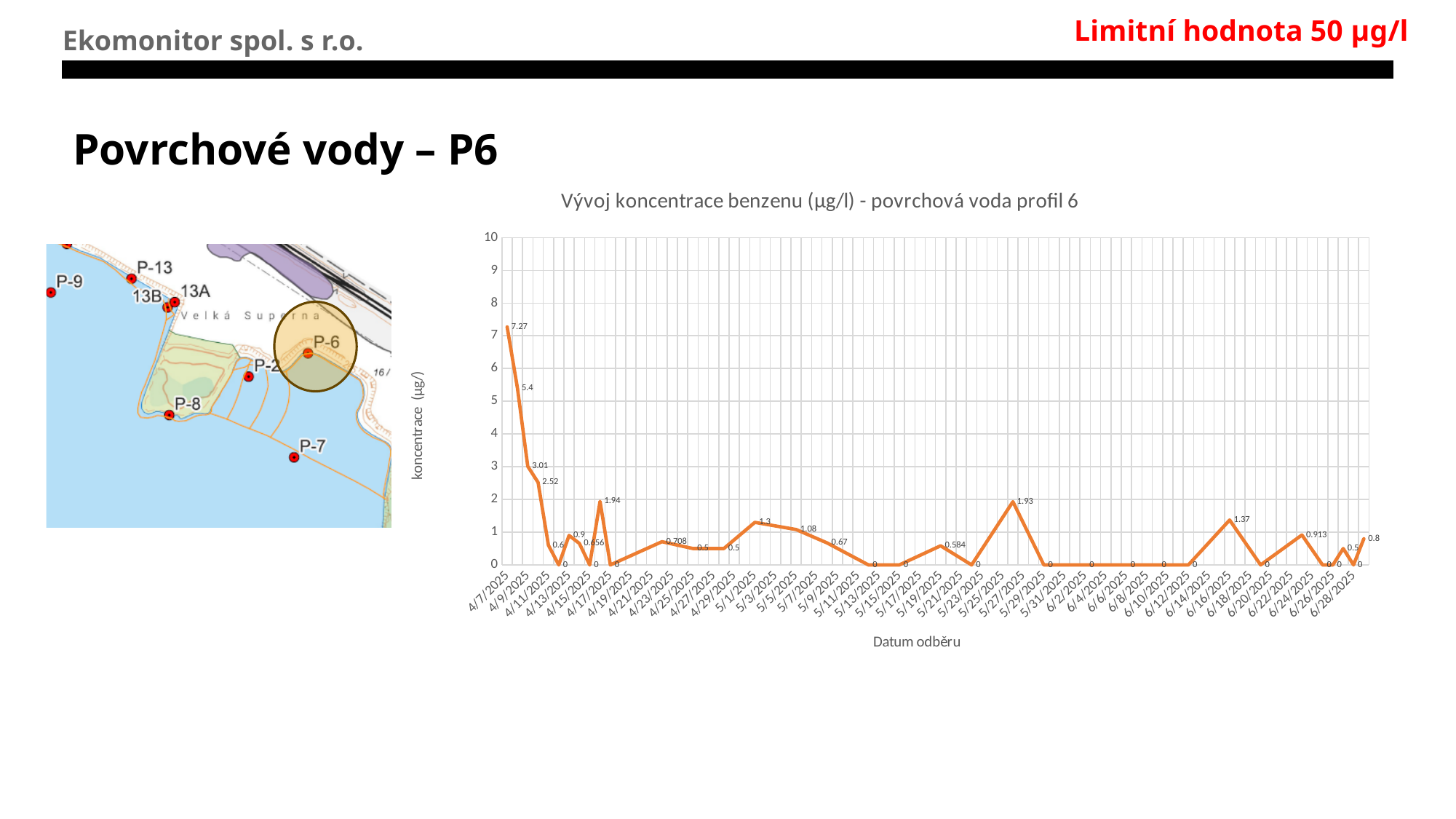
What is the lowest value plotted on the chart? 0 Is the highest value on the chart greater or less than 8? less Which is larger, the value for 4/7/2025 or the value for 6/28/2025? 4/7/2025 What kind of chart is shown on the slide? line chart What is the title of the chart? Vývoj koncentrace benzenu (µg/l) - povrchová voda profil 6 What is the value plotted for 4/7/2025? 7.27 What is the highest value plotted on the chart? 7.27 What is the label of the vertical axis of the chart? koncentrace (µg/l) Is the value for 4/7/2025 greater or less than 5? greater Overall, do the values rise or fall from the start to the end of the x axis? fall